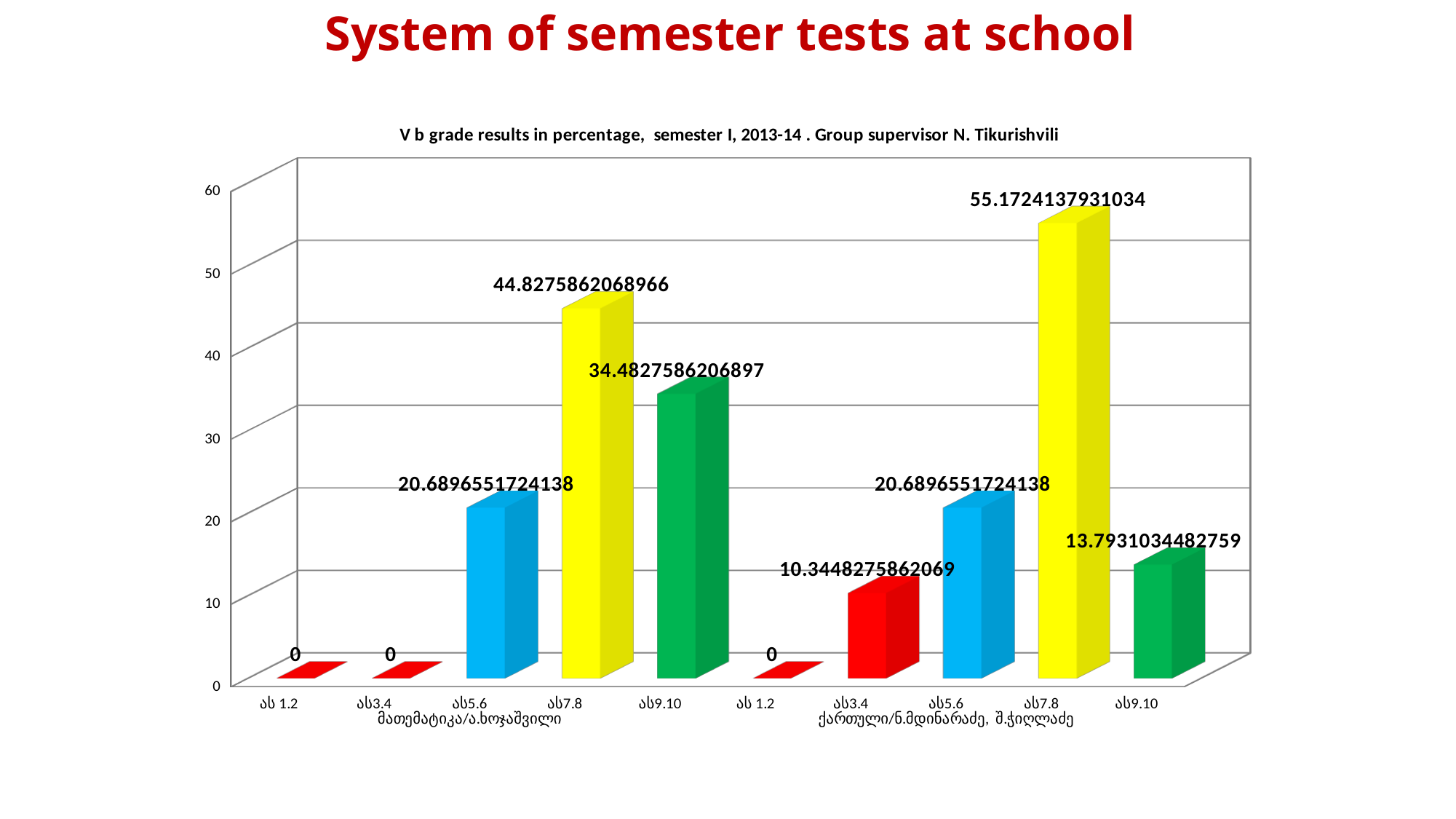
What type of chart is shown on the slide? bar chart Which is larger: ას9.10 in the მათემატიკა group or ას9.10 in the ქართული group? ას9.10 in the მათემატიკა group What is the value for ას7.8 in the left group (მათემატიკა/ა.ხოჯაშვილი)? 44.8275862068966 What is the title of the chart? V b grade results in percentage, semester I, 2013-14 . Group supervisor N. Tikurishvili How many bars show a value of 0? 3 Which bar has the highest value on the chart? ას7.8 in the ქართული group (55.1724137931034) Is the value for ას5.6 in the left group greater or less than 30? less What is the value for ას3.4 in the right group (ქართული)? 10.3448275862069 How many bars are plotted on the chart in total? 10 What is the value for ას9.10 in the left group (მათემატიკა)? 34.4827586206897 What is the value for ას7.8 in the right group (ქართული/ნ.მდინარაძე, შ.ჭიღლაძე)? 55.1724137931034 What colour are the ას7.8 bars? yellow